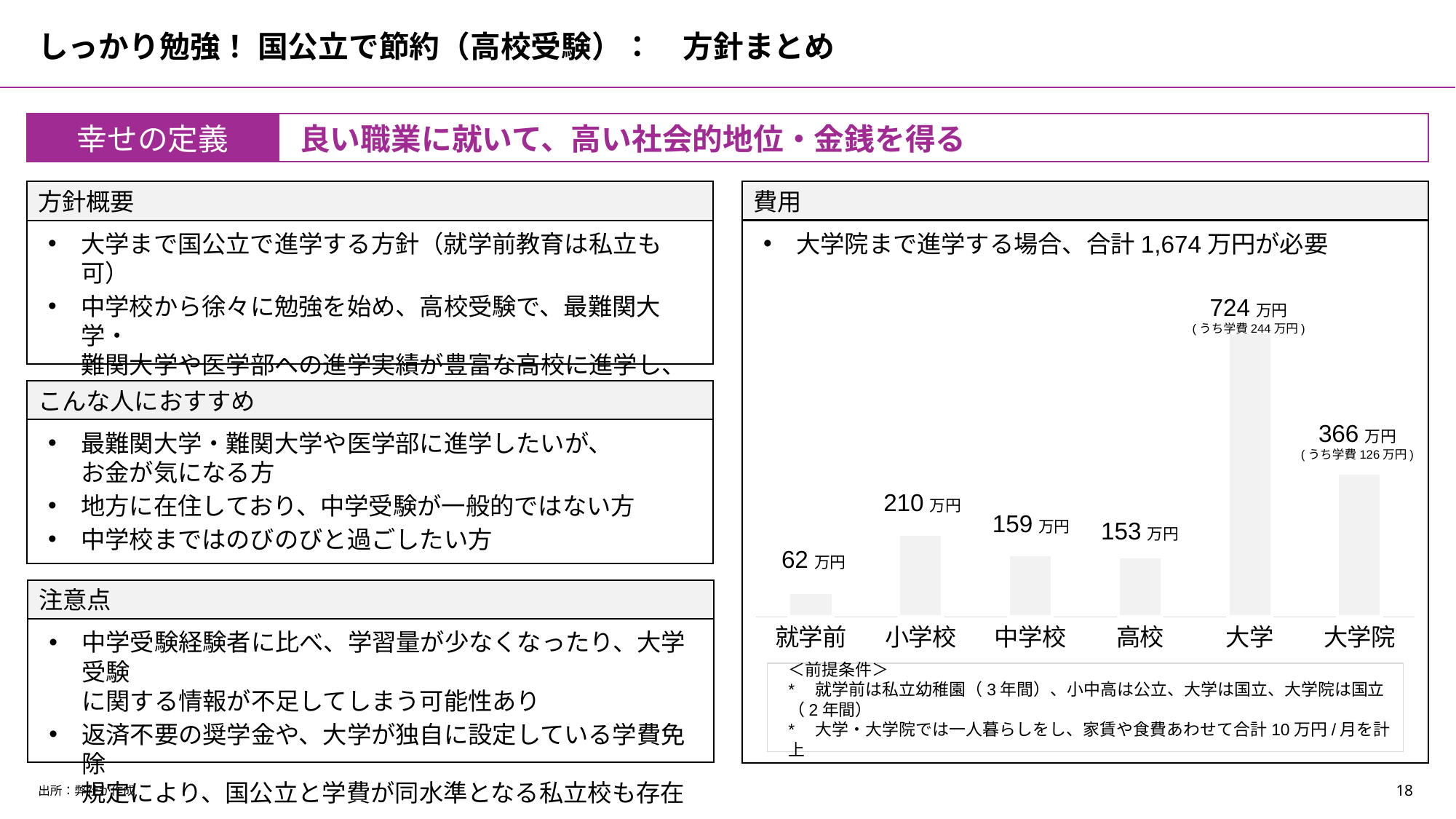
According to the 費用 chart, how much of the 大学 cost is 学費? 244万円 What is the difference between the values for 小学校 and 中学校 in the 費用 chart? 51万円 Which is larger in the 費用 chart, the value for 中学校 or the value for 高校? 中学校 What type of chart is shown in the 費用 section? bar chart Which category has the lowest value in the 費用 chart? 就学前 What is the difference between the values for 大学 and 大学院 in the 費用 chart? 358万円 What is the value for 就学前 in the 費用 chart? 62万円 What is the value for 大学院 in the 費用 chart? 366万円 What is the total of all six values in the 費用 chart? 1,674万円 Which category has the highest value in the 費用 chart? 大学 How many categories are shown on the x axis of the 費用 chart? 6 What is the value for 小学校 in the 費用 chart? 210万円